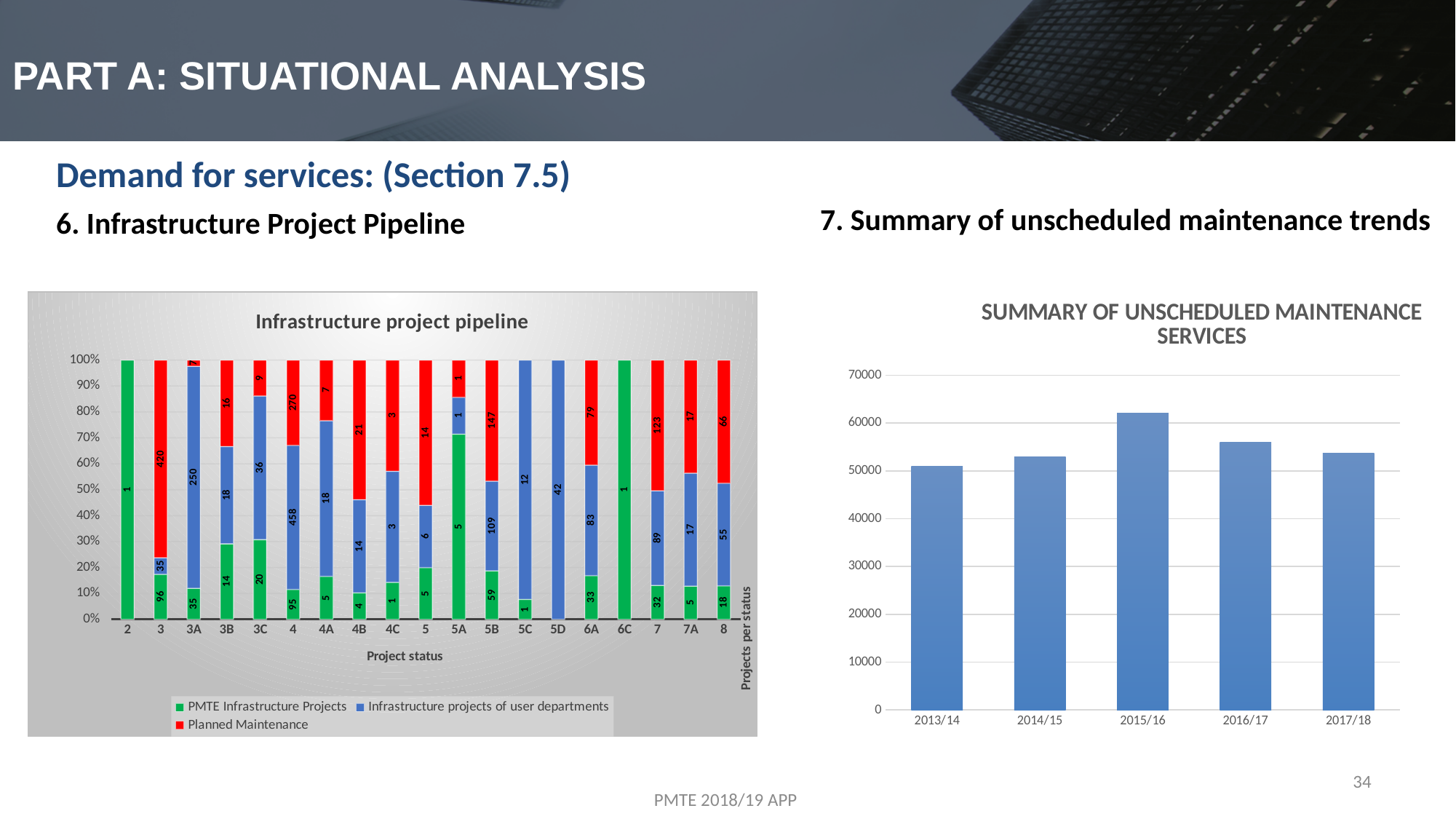
In the 'Infrastructure project pipeline' chart, what is the total of the three series for project status 7? 244 In the 'SUMMARY OF UNSCHEDULED MAINTENANCE SERVICES' chart, is the value for 2015/16 greater or less than 60000? greater In the 'Infrastructure project pipeline' chart, what is the Planned Maintenance value for project status 3? 420 In the 'Infrastructure project pipeline' chart, what is the difference between the Planned Maintenance values for project status 5B and project status 7? 24 In the 'Infrastructure project pipeline' chart, what is the value for Infrastructure projects of user departments at project status 4? 458 In the 'Infrastructure project pipeline' chart, how many project status categories are shown on the x axis? 19 In the 'Infrastructure project pipeline' chart, which colour represents Planned Maintenance? Red In the 'SUMMARY OF UNSCHEDULED MAINTENANCE SERVICES' chart, is the value for 2016/17 greater or less than 60000? less What kind of chart is the 'SUMMARY OF UNSCHEDULED MAINTENANCE SERVICES' chart? Bar chart In the 'SUMMARY OF UNSCHEDULED MAINTENANCE SERVICES' chart, which year has the highest value? 2015/16 In the 'Infrastructure project pipeline' chart, what is the PMTE Infrastructure Projects value for project status 5B? 59 In the 'Infrastructure project pipeline' chart, how many series does the legend list? 3